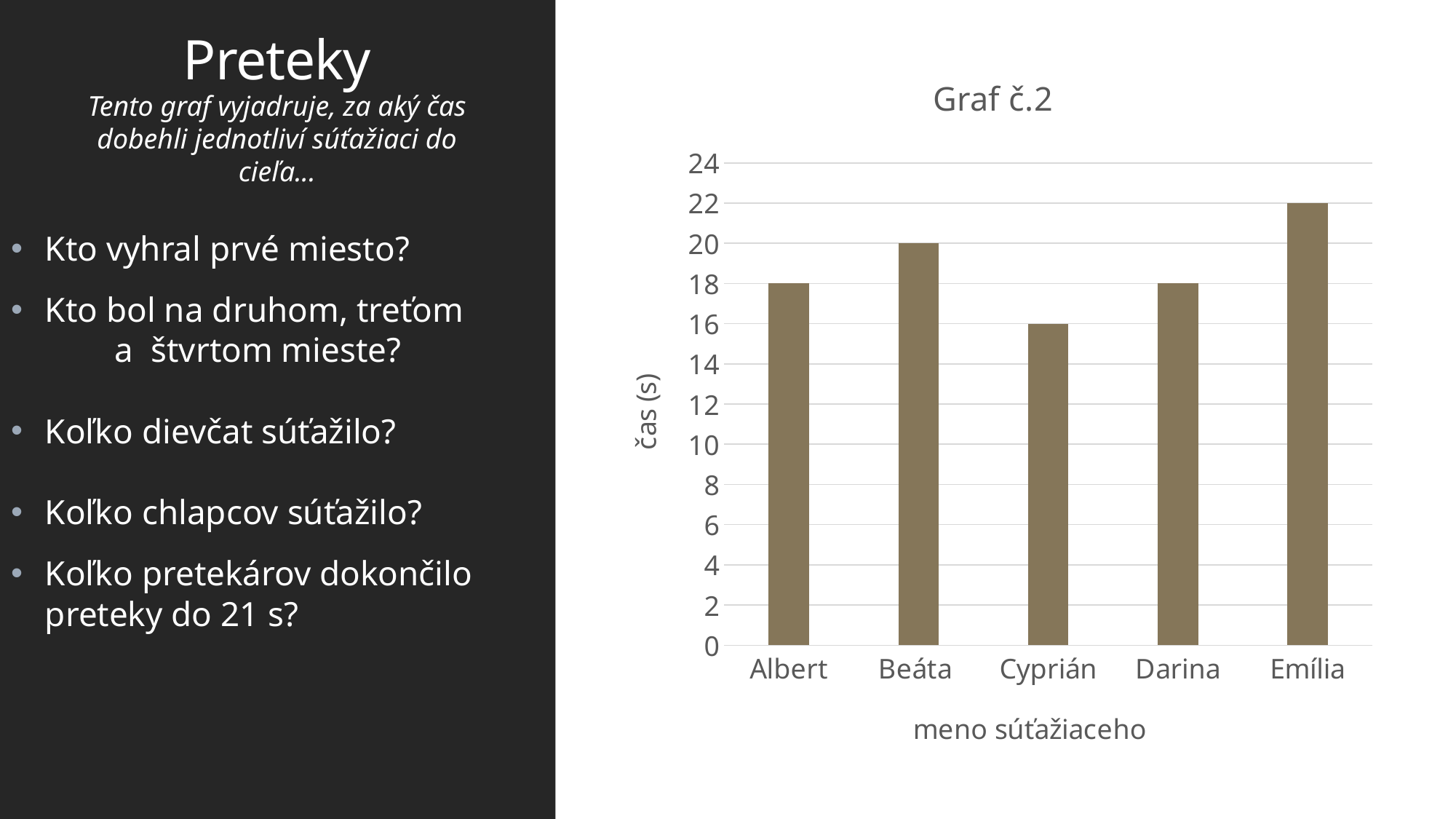
Is the value for Darina greater or less than 20? less What kind of chart is shown on the slide? bar chart Which is larger, the value for Beáta or the value for Albert? Beáta What is the difference between Emília's value and Cyprián's value? 6 Which competitor has the highest value? Emília What is the label of the y axis? čas (s) What is the time value for Cyprián? 16 Which competitor has the lowest value? Cyprián How many competitors (categories) are shown on the x axis? 5 What is the title of the chart? Graf č.2 What is the time value for Beáta? 20 What is the time value for Emília? 22